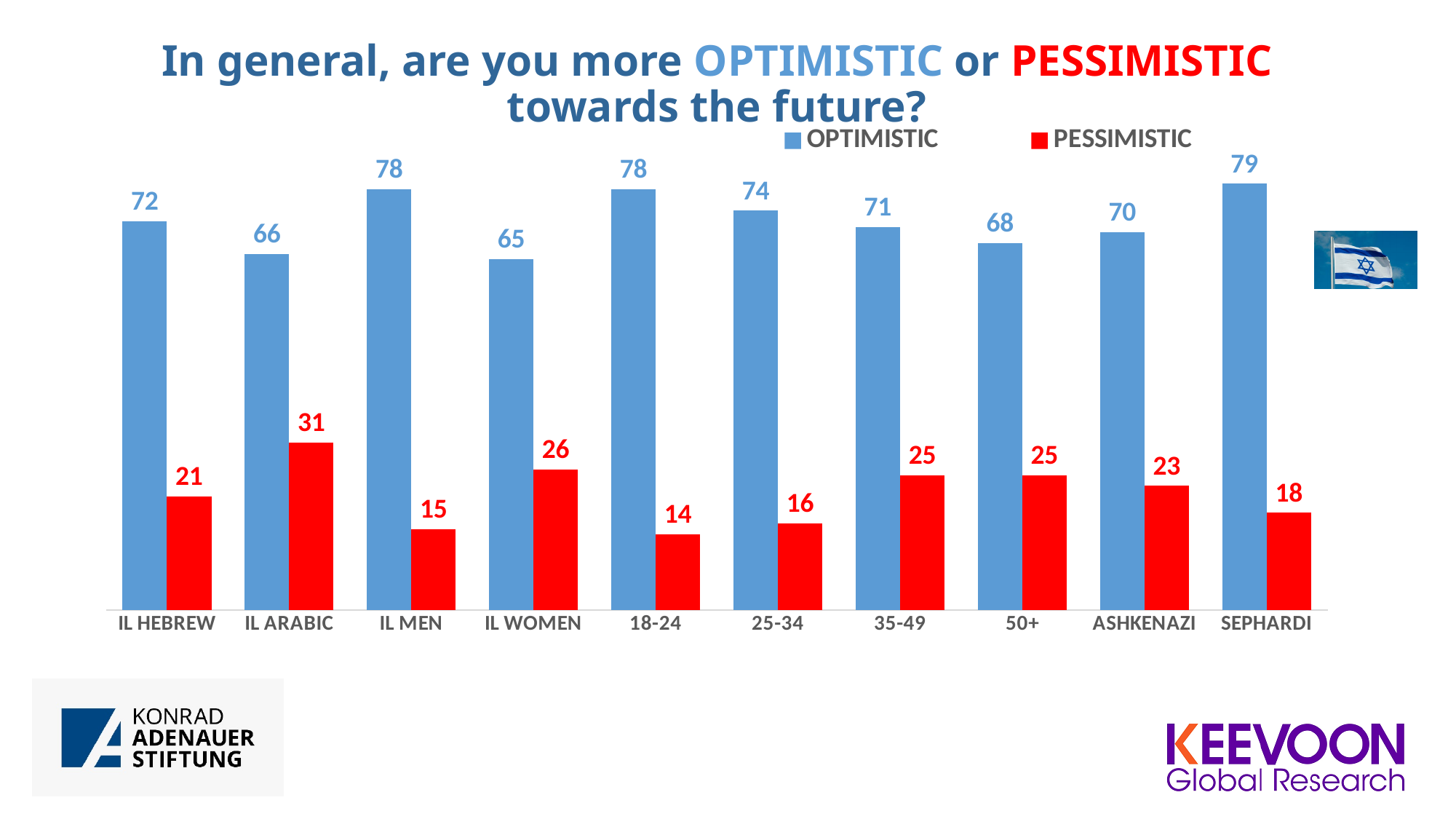
What is the OPTIMISTIC value for 25-34? 74 How many series does the legend list? 2 What kind of chart is shown on the slide? Bar chart What is the OPTIMISTIC value for IL ARABIC? 66 Which category has the lowest PESSIMISTIC value? 18-24 Which category has the highest OPTIMISTIC value? SEPHARDI Which category has the highest PESSIMISTIC value? IL ARABIC Which is larger, the OPTIMISTIC value for IL MEN or for IL WOMEN? IL MEN What is the difference between the OPTIMISTIC and PESSIMISTIC values for IL HEBREW? 51 What is the PESSIMISTIC value for IL WOMEN? 26 What colour are the PESSIMISTIC bars? Red How many categories are shown on the x axis? 10